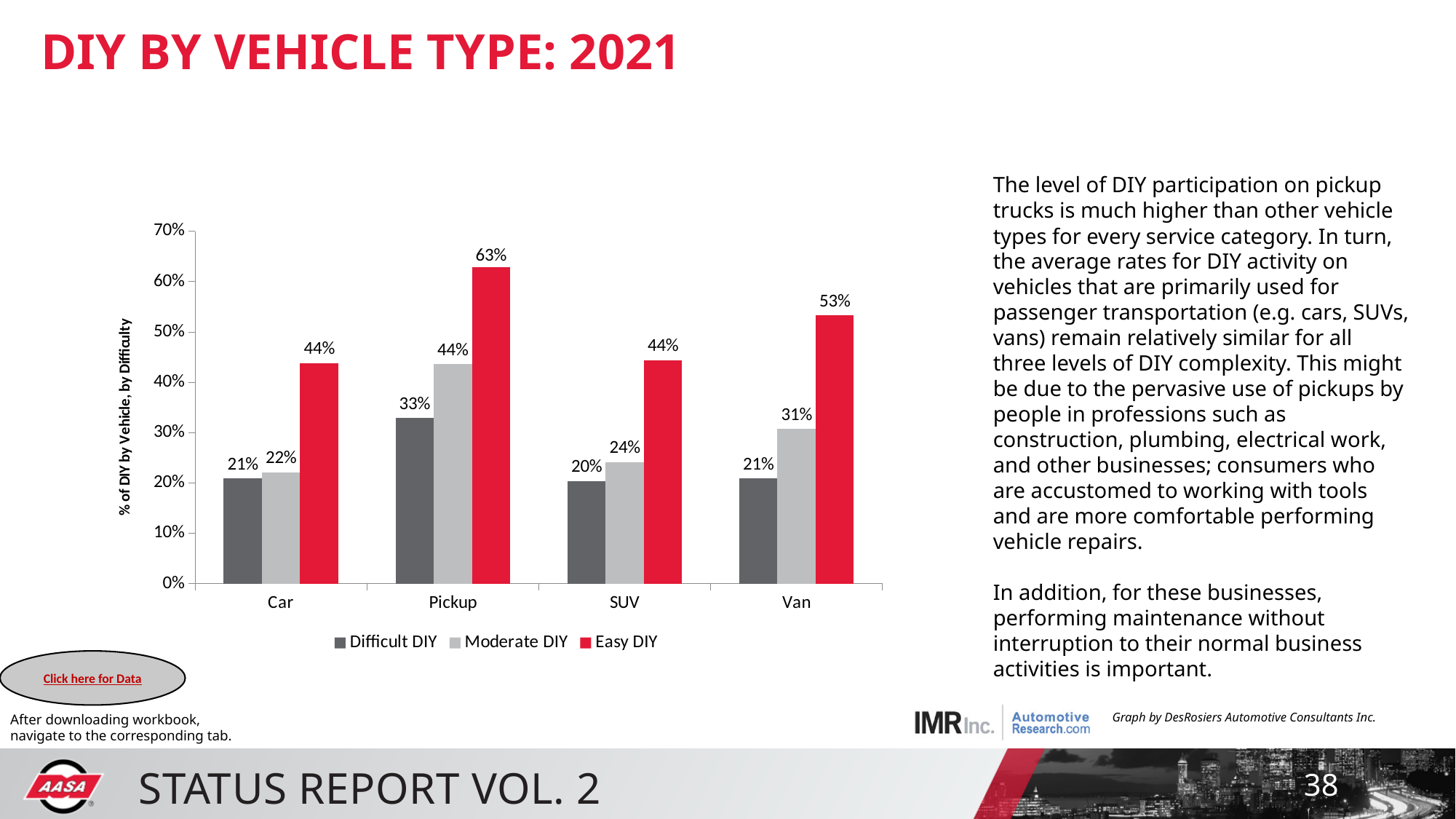
How many vehicle types are shown on the x axis? 4 What is the Moderate DIY value for Van? 31% What is the Difficult DIY value for SUV? 20% Is the Easy DIY value for Van greater or less than 50%? greater What is the Easy DIY value for Pickup? 63% Which vehicle type has the highest Easy DIY value? Pickup What is the difference between the Easy DIY values for Pickup and Van? 10% Which vehicle type has the lowest Difficult DIY value? SUV How many series does the legend list? 3 Which is larger: the Moderate DIY value for Van or the Moderate DIY value for SUV? Van What is the difference between the Moderate DIY and Difficult DIY values for Pickup? 11% What kind of chart is shown on the slide? Bar chart